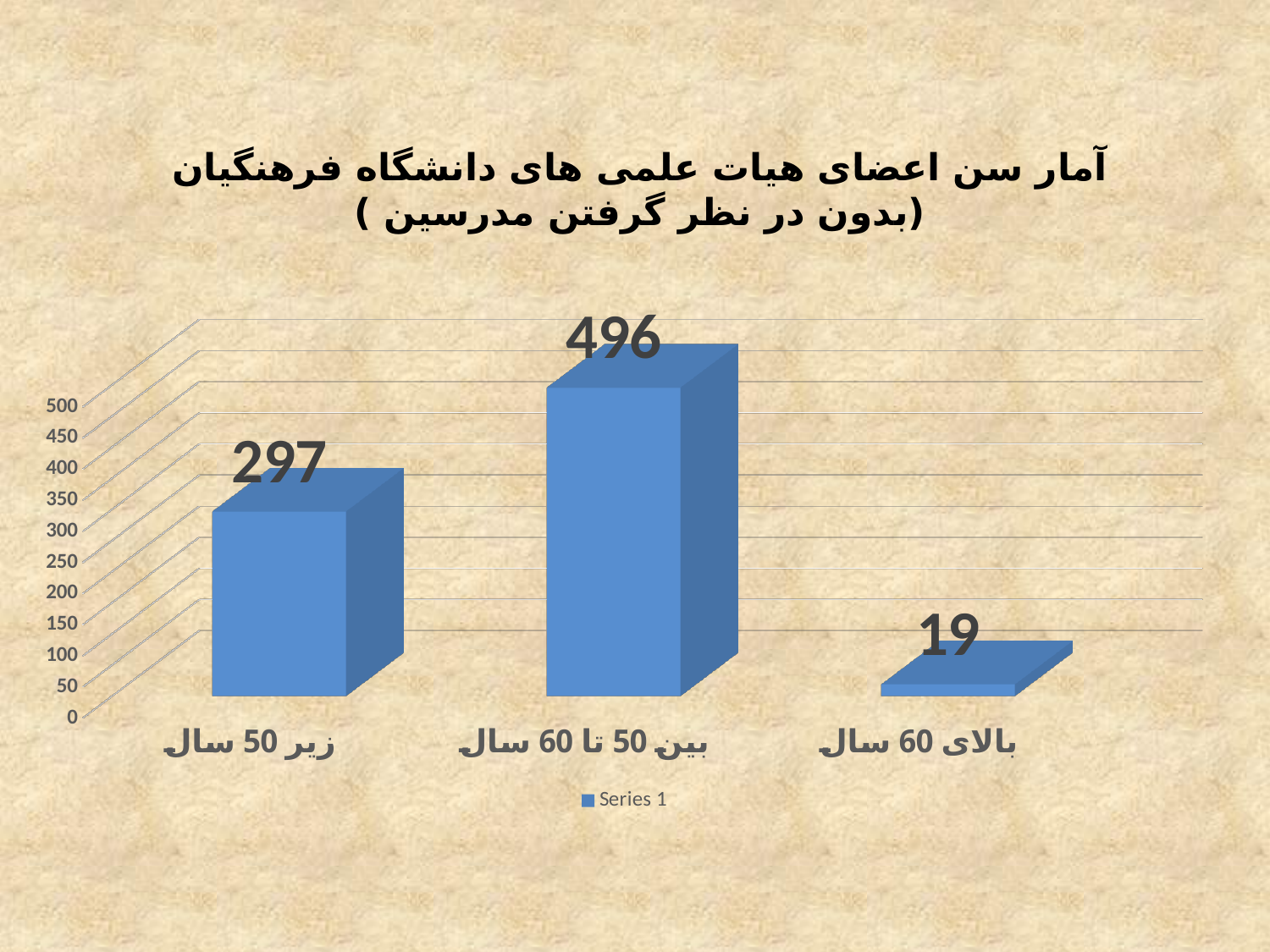
What kind of chart is shown on the slide? bar chart Which category has the lowest value? بالای 60 سال Is the value for "زیر 50 سال" greater or less than 250? greater How many categories are shown on the x axis? 3 What is the difference between the values for "بین 50 تا 60 سال" and "زیر 50 سال"? 199 How many series does the legend list? 1 What is the value for the category "زیر 50 سال"? 297 What is the difference between the values for "زیر 50 سال" and "بالای 60 سال"? 278 Which is larger, the value for "زیر 50 سال" or the value for "بالای 60 سال"? زیر 50 سال What is the value for the category "بالای 60 سال"? 19 Which category has the highest value? بین 50 تا 60 سال What is the value for the category "بین 50 تا 60 سال"? 496